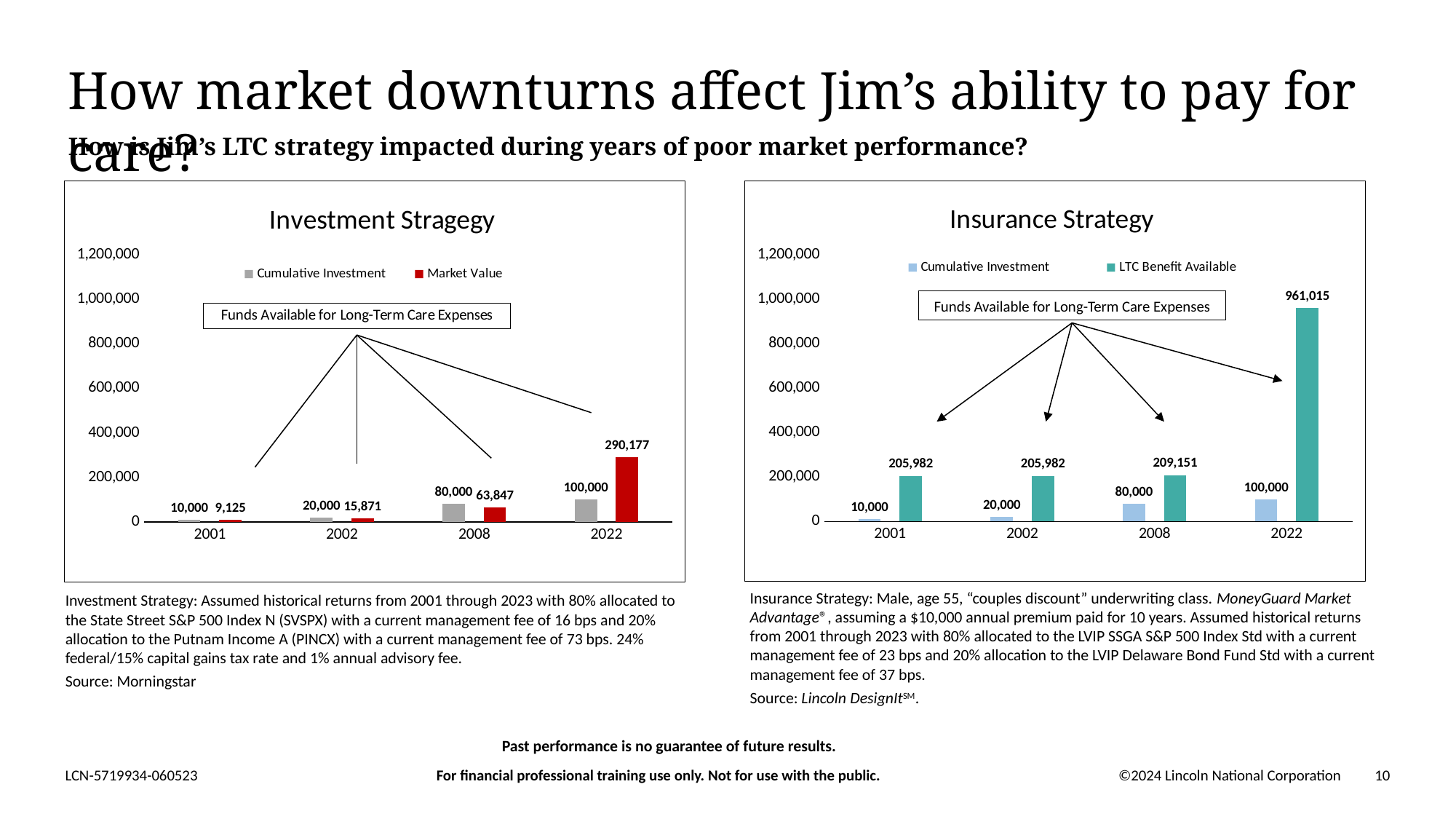
What type of chart is the Insurance Strategy chart? Bar chart In the Insurance Strategy chart, what is the difference between the LTC Benefit Available and the Cumulative Investment in 2022? 861,015 In the Investment Stragegy chart, what is the Market Value in 2008? 63,847 How many series does the legend of the Investment Stragegy chart list? 2 How many years are shown on the x axis of the Insurance Strategy chart? 4 In the Insurance Strategy chart, which year has the highest LTC Benefit Available? 2022 In the Investment Stragegy chart, what is the difference between the Cumulative Investment and the Market Value in 2002? 4,129 In the Investment Stragegy chart, which is larger in 2001: the Cumulative Investment or the Market Value? Cumulative Investment In the Investment Stragegy chart, what is the Market Value in 2022? 290,177 In the Insurance Strategy chart, what is the LTC Benefit Available in 2022? 961,015 In the Insurance Strategy chart, what is the LTC Benefit Available in 2008? 209,151 In the Investment Stragegy chart, which year has the lowest Market Value? 2001